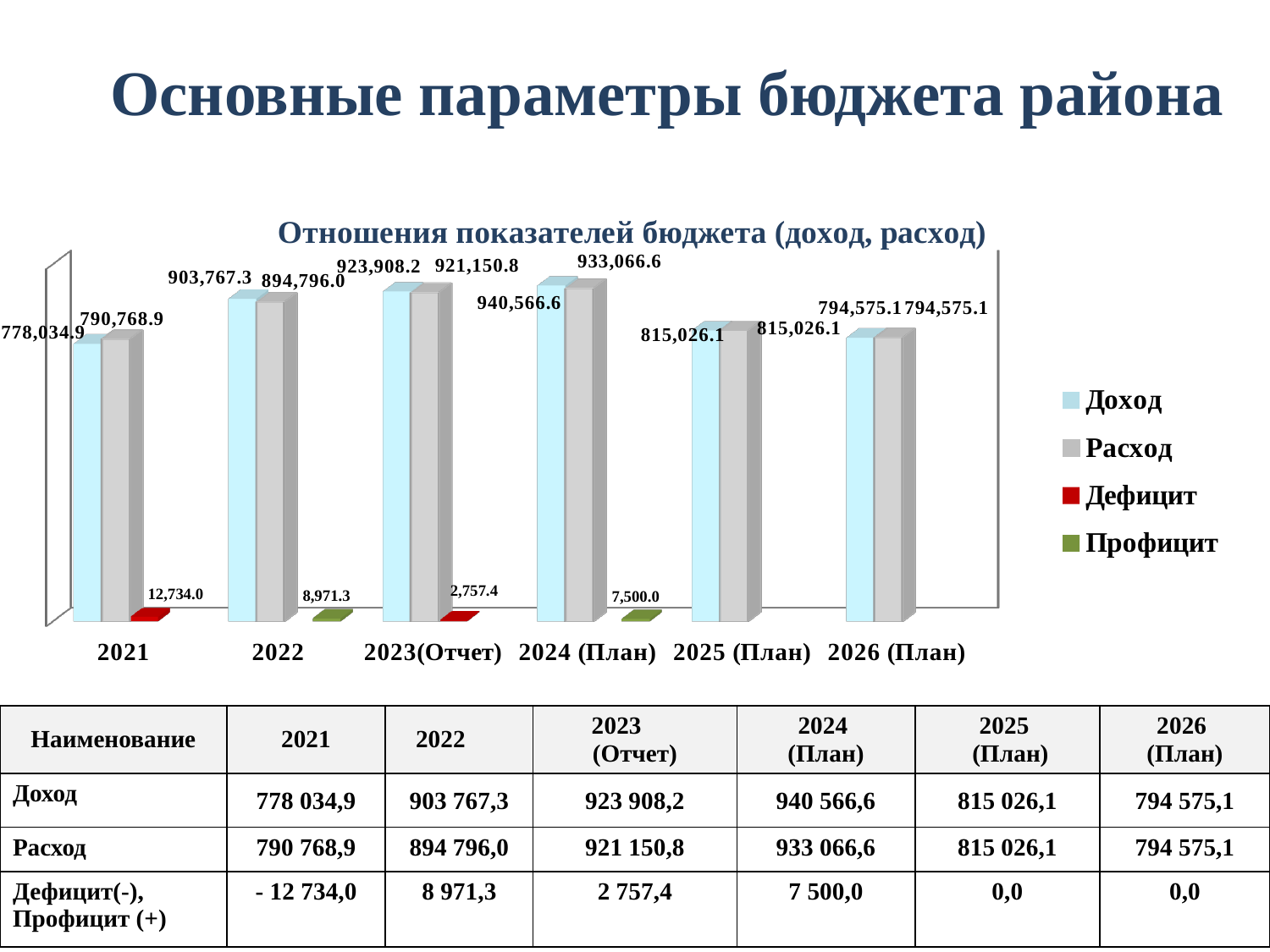
Does the Доход value rise or fall from 2024 (План) to 2026 (План)? Falls How many year categories are shown on the x axis of the chart? 6 What is the value of Доход for 2025 (План) in the chart? 815,026.1 What is the value of Доход for 2021 in the chart? 778,034.9 For 2022, which is larger in the chart: Доход or Расход? Доход What kind of chart is shown on the slide? Bar chart Which year has the lowest Расход value in the chart? 2021 What is the value of Расход for 2023(Отчет) in the chart? 921,150.8 What is the difference between Доход and Расход for 2024 (План) in the chart? 7,500.0 How many series does the chart legend list? 4 Which year has the highest Доход value in the chart? 2024 (План) What is the difference between Расход and Доход for 2021 in the chart? 12,734.0